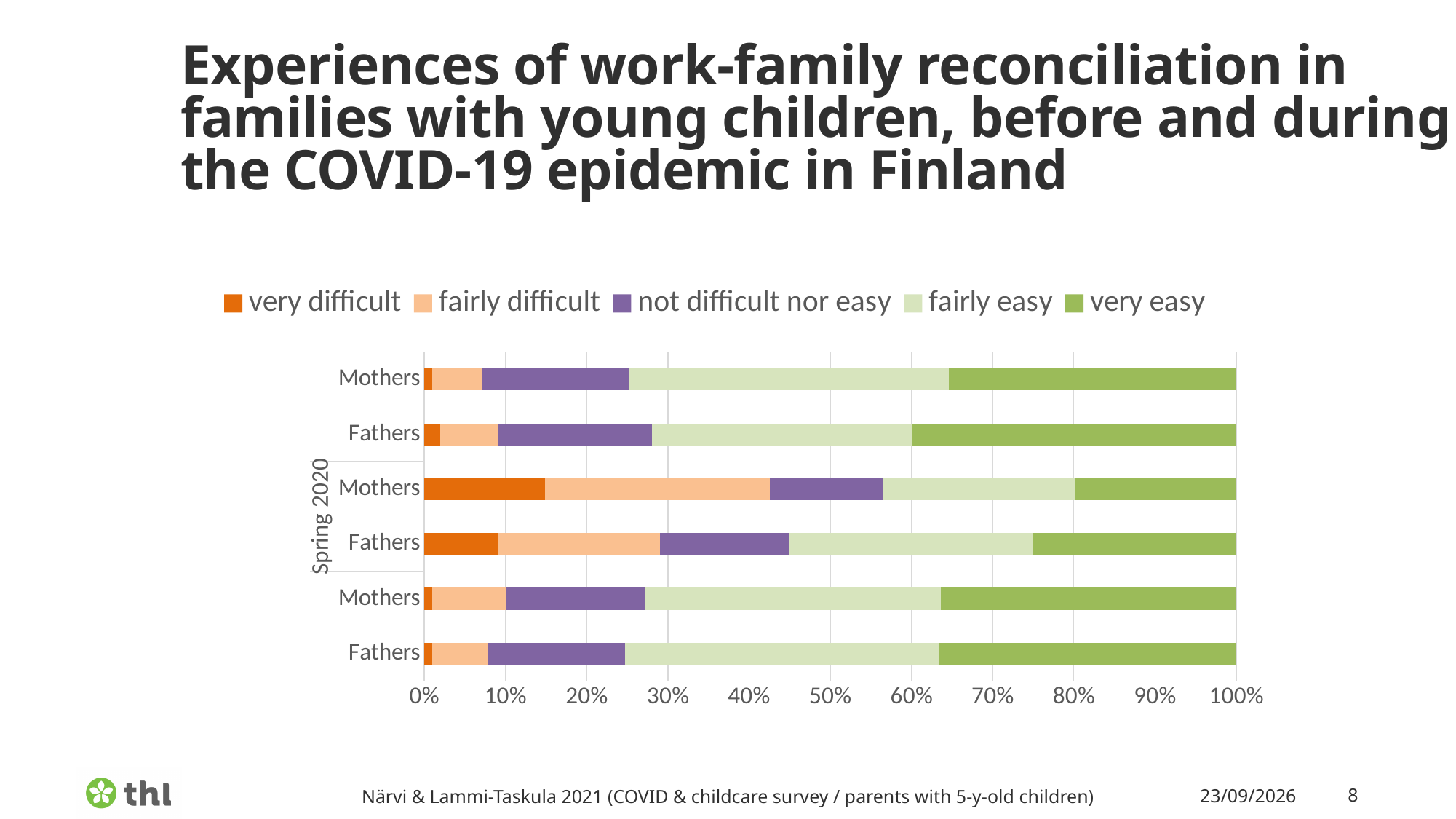
What kind of chart is shown on the slide? stacked bar chart Is the 'very difficult' value for Mothers in Spring 2020 greater or less than 10%? greater Is the 'fairly difficult' value for Mothers in Spring 2020 greater or less than 20%? greater Is the 'very easy' value for the top Mothers bar greater or less than 30%? greater Which bar has the largest 'fairly difficult' segment? Mothers, Spring 2020 Which legend entry is shown in dark green? very easy What is the total of each stacked bar, as shown by the axis? 100% How many series does the legend list? 5 How many bars are plotted in the chart? 6 Which has the larger 'very easy' share, the top Mothers bar or the Spring 2020 Mothers bar? the top Mothers bar In Spring 2020, which has the larger 'very difficult' share, Mothers or Fathers? Mothers